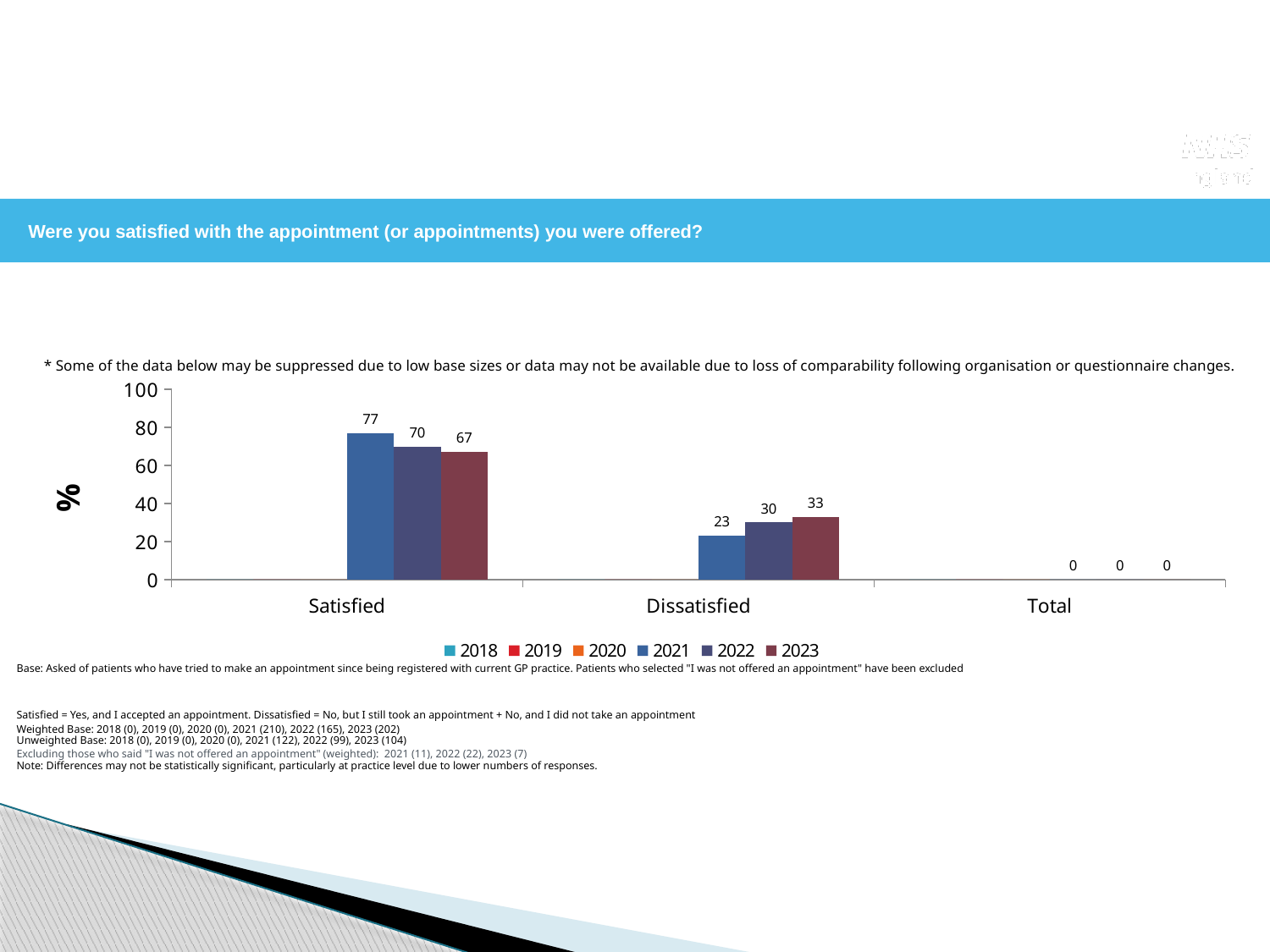
Which is larger: the 2022 value for Satisfied or the 2022 value for Dissatisfied? Satisfied What is the label on the y axis? % Which year has the highest value in the Satisfied category? 2021 What type of chart is shown on the slide? Bar chart How many categories are shown on the x axis? 3 How many series does the legend list? 6 What is the difference between the 2021 and 2023 values in the Satisfied category? 10 What is the value for 2021 in the Satisfied category? 77 What is the value for 2022 in the Satisfied category? 70 Is the 2023 value for Satisfied greater or less than 60? greater What is the value for 2023 in the Dissatisfied category? 33